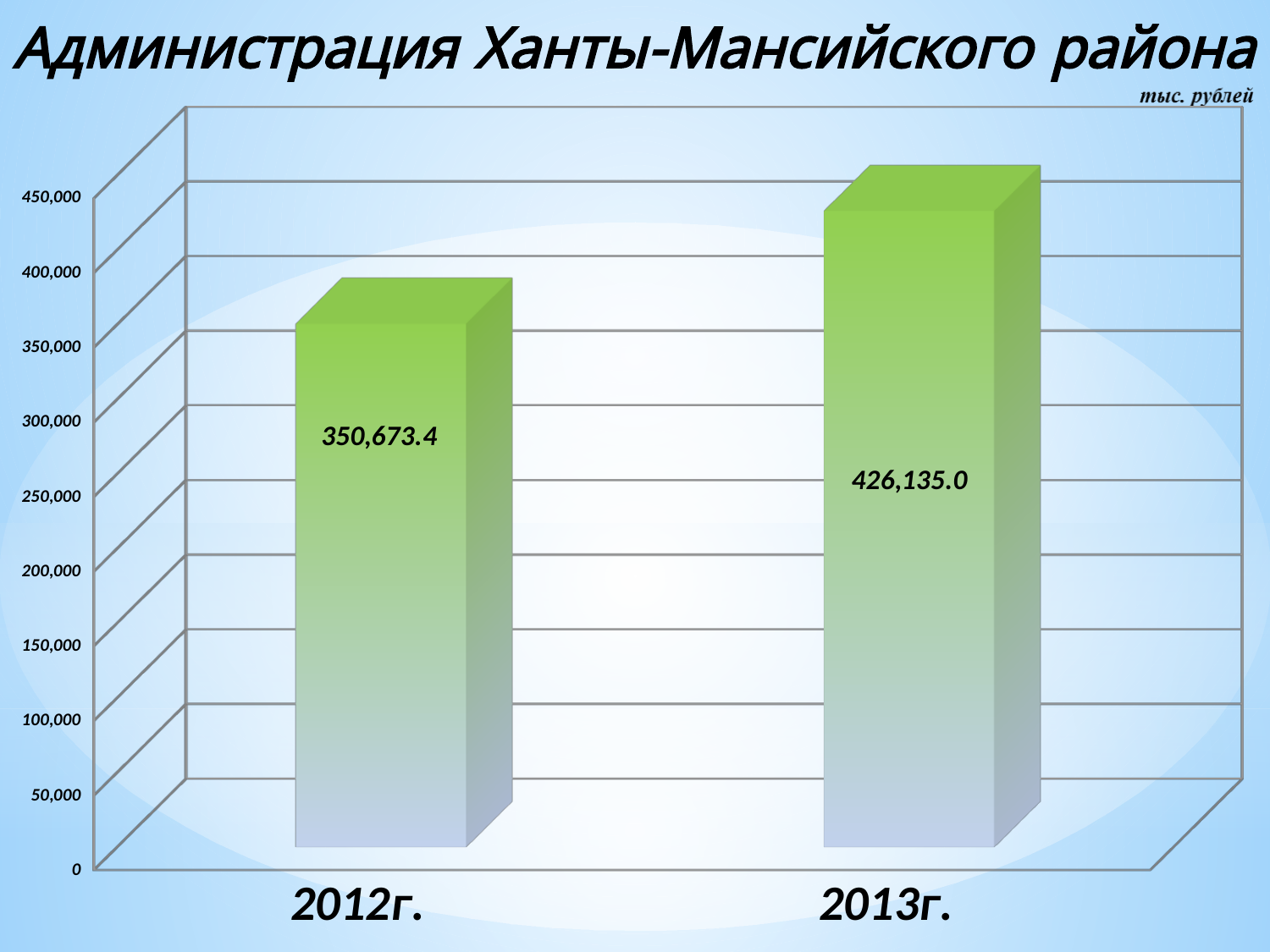
Which year has the highest value? 2013г. Is the value for 2012г. greater or less than 400,000? less Which is larger, the value for 2012г. or the value for 2013г.? 2013г. Which year has the lowest value? 2012г. Do the values rise or fall from 2012г. to 2013г.? rise What is the difference between the values for 2013г. and 2012г.? 75,461.6 What is the value for 2012г.? 350,673.4 How many categories are shown on the x axis? 2 Is the value for 2013г. greater or less than 400,000? greater What is the value for 2013г.? 426,135.0 What kind of chart is shown on the slide? bar chart What unit is indicated above the chart? тыс. рублей